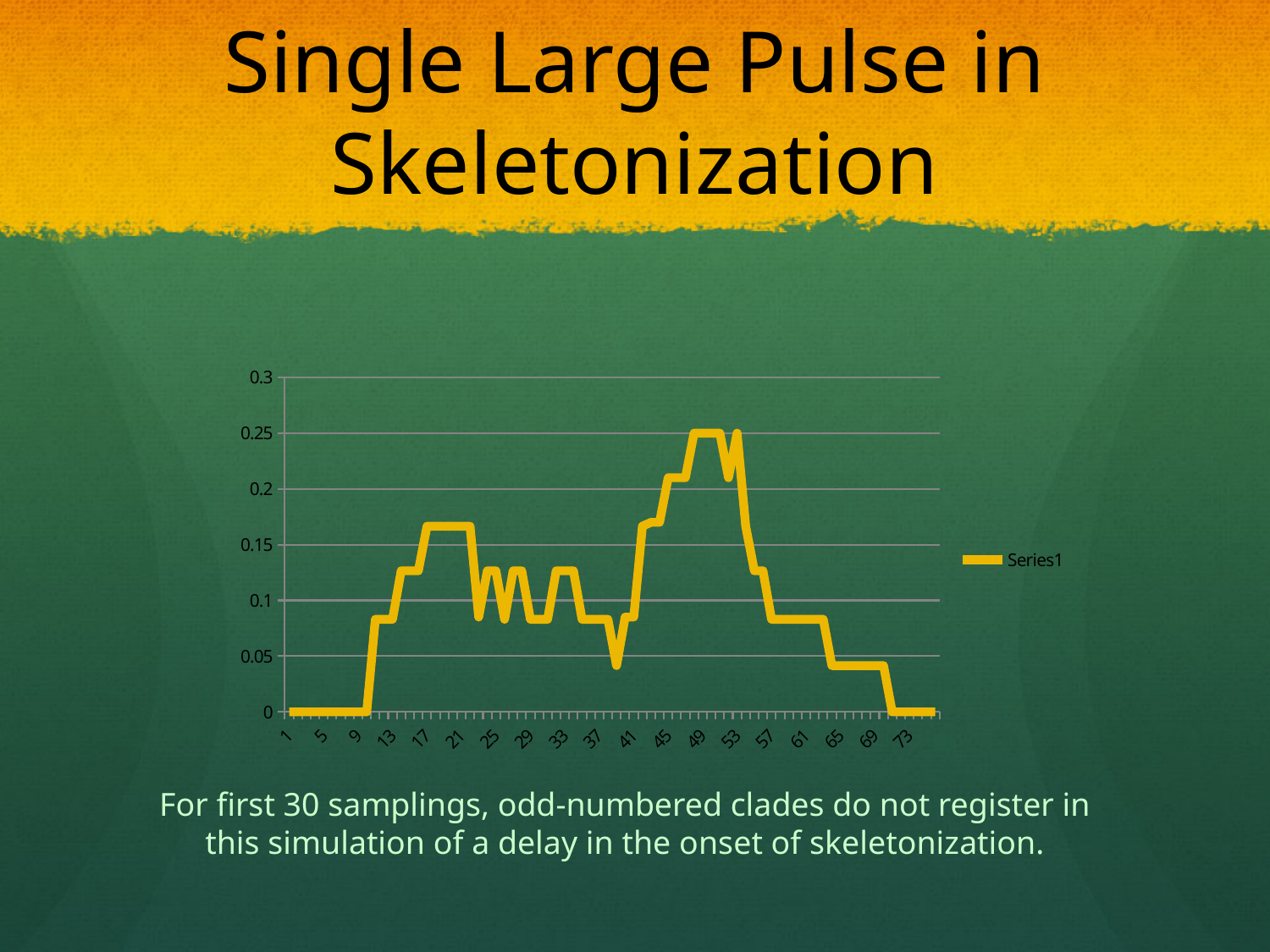
Between x = 53 and x = 73, does the line generally rise or fall? fall Is the value of Series1 at x = 49 greater or less than 0.2? greater What is the value of Series1 at x = 1? 0 What kind of chart is shown on the slide? line chart What is the value of Series1 at x = 73? 0 Is the value of Series1 at x = 17 greater or less than 0.15? greater Is the peak value of Series1 greater or less than 0.2? greater How many labels are printed along the x axis? 19 What is the name of the series shown in the legend? Series1 What is the highest value shown on the y axis? 0.3 How many series does the legend list? 1